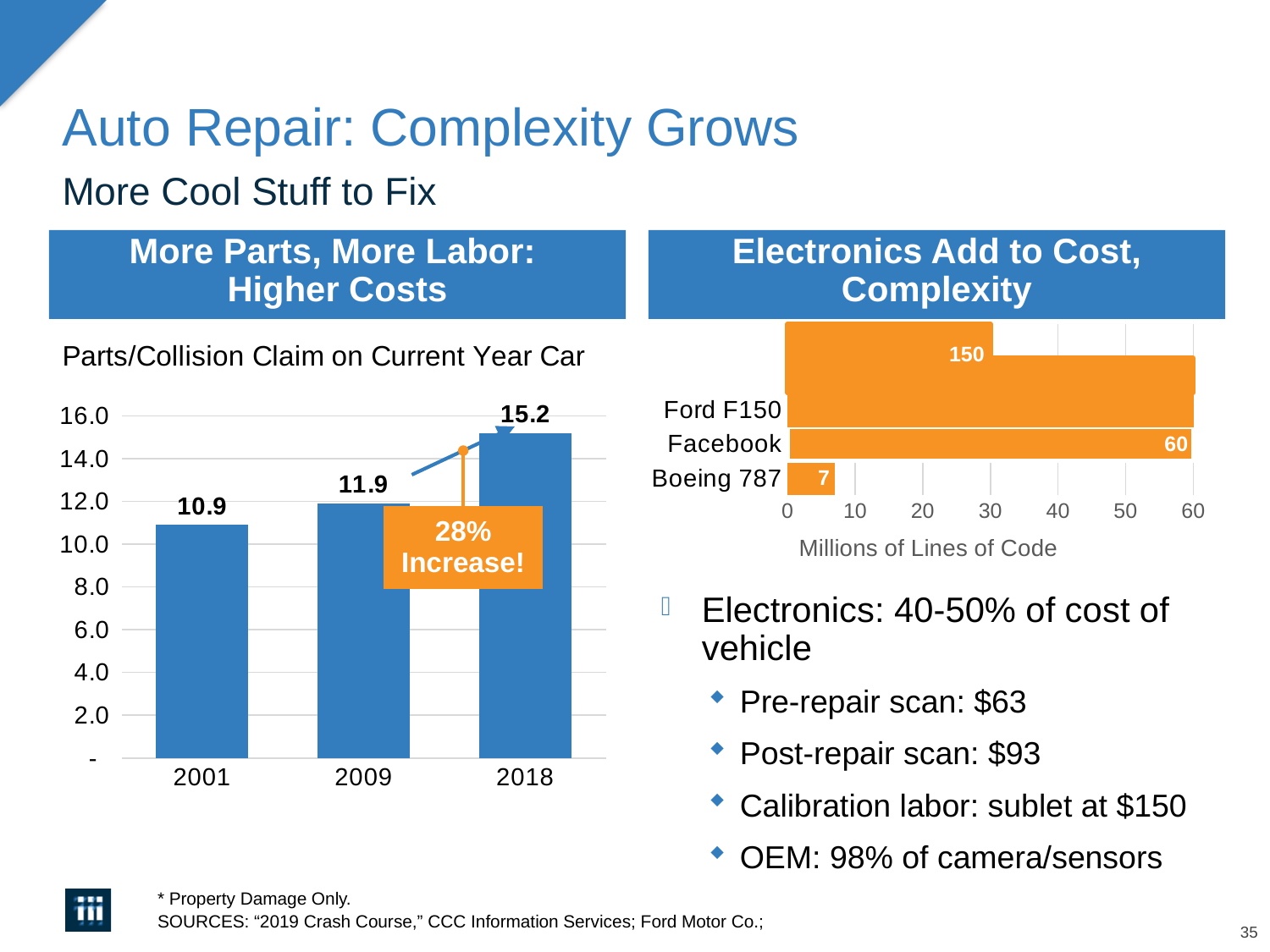
In the Parts/Collision Claim on Current Year Car chart, what is the value for 2001? 10.9 In the Millions of Lines of Code chart, which category has the highest value? Ford F150 How many years are shown in the Parts/Collision Claim on Current Year Car chart? 3 In the Millions of Lines of Code chart, what is the value for the Boeing 787? 7 In the Millions of Lines of Code chart, how many millions of lines of code does the Ford F150 have? 150 In the Millions of Lines of Code chart, which is larger, Facebook or Boeing 787? Facebook In the Parts/Collision Claim on Current Year Car chart, what is the value for 2018? 15.2 What kind of chart is the Parts/Collision Claim on Current Year Car chart? bar chart In the Parts/Collision Claim on Current Year Car chart, which year has the lowest value? 2001 In the Millions of Lines of Code chart, what is the difference between the Ford F150 and Facebook values? 90 In the Parts/Collision Claim on Current Year Car chart, do the values rise or fall from 2001 to 2018? rise In the Parts/Collision Claim on Current Year Car chart, what is the difference between the 2018 and 2009 values? 3.3